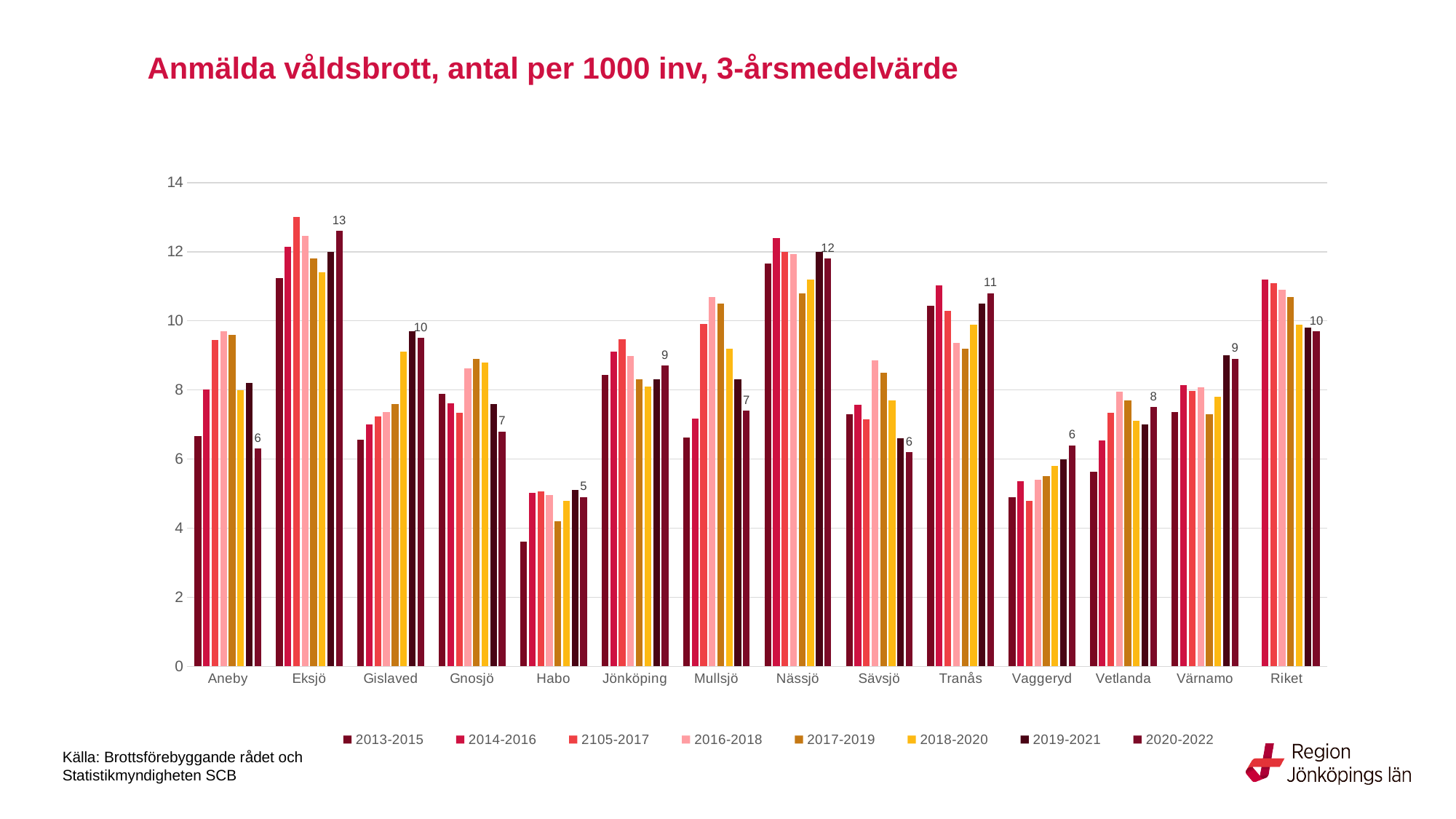
What is the difference between the 2020-2022 values for Eksjö and Habo? 8 In the 2020-2022 series, which is larger: Nässjö or Vetlanda? Nässjö Which category has the lowest value in the 2020-2022 series? Habo What is the value for Eksjö in the 2020-2022 series? 13 What is the value for Tranås in the 2020-2022 series? 11 What is the value for Riket in the 2020-2022 series? 10 How many categories are shown on the x axis? 14 Is the value for Habo in the 2013-2015 series greater or less than 4? less Which category has the highest value in the 2020-2022 series? Eksjö What kind of chart is shown on the slide? Bar chart What is the value for Habo in the 2020-2022 series? 5 How many series does the legend list? 8